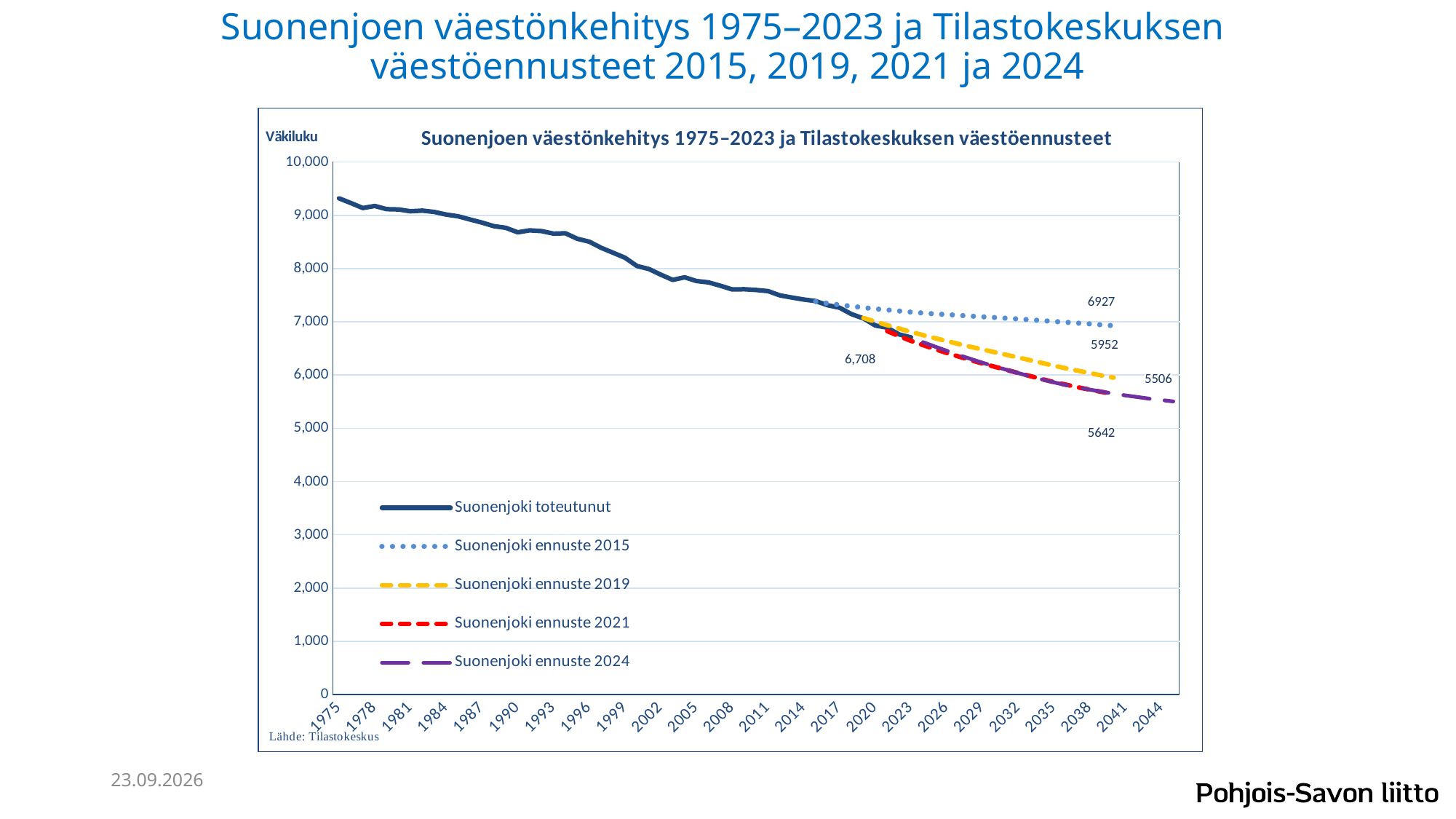
What is the final labelled value of the Suonenjoki ennuste 2024 series? 5506 What is the final labelled value of the Suonenjoki ennuste 2015 series? 6927 Which forecast series ends at a higher value, Suonenjoki ennuste 2015 or Suonenjoki ennuste 2019? Suonenjoki ennuste 2015 What is the final labelled value of the Suonenjoki ennuste 2019 series? 5952 What is the difference between the final value of ennuste 2019 (5952) and the final value of ennuste 2021 (5642)? 310 How many series does the legend list? 5 What is the last labelled value of the Suonenjoki toteutunut series? 6,708 Is the value of Suonenjoki toteutunut in 1975 greater or less than 9,000? greater Does the Suonenjoki toteutunut series rise or fall from 1975 to 2023? fall Which forecast series ends at the lowest value? Suonenjoki ennuste 2024 What kind of chart is shown on the slide? line chart What is the difference between the final value of ennuste 2015 (6927) and the final value of ennuste 2024 (5506)? 1421